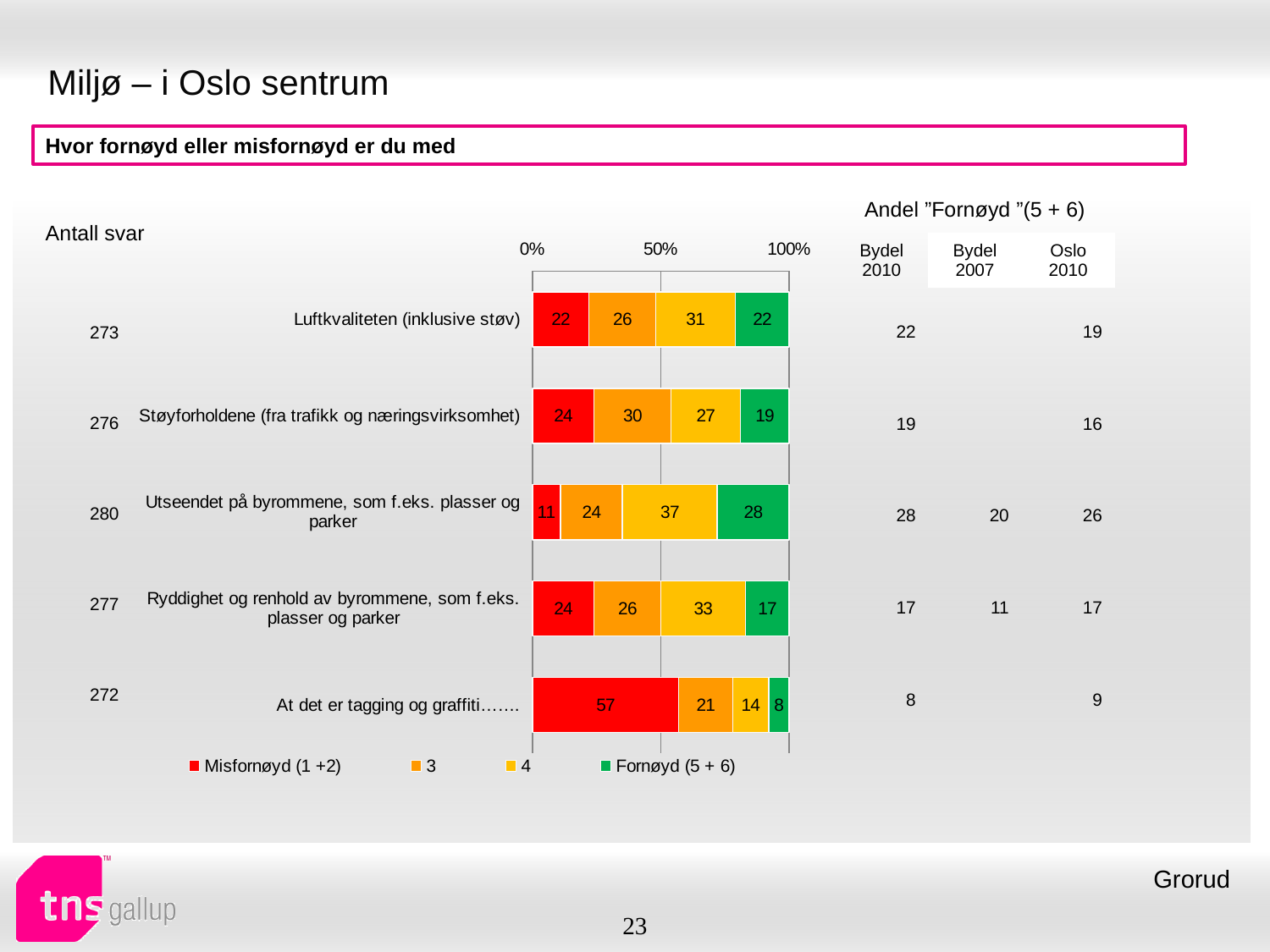
Which category has the highest Fornøyd (5 + 6) value? Utseendet på byrommene, som f.eks. plasser og parker Which is larger: the Fornøyd (5 + 6) value for Støyforholdene (fra trafikk og næringsvirksomhet) or for Ryddighet og renhold av byrommene, som f.eks. plasser og parker? Støyforholdene (fra trafikk og næringsvirksomhet) What is the total of the stacked bar for Støyforholdene (fra trafikk og næringsvirksomhet)? 100 How many categories are shown in the chart? 5 What is the difference between the Misfornøyd (1 +2) value for At det er tagging og graffiti… and the Misfornøyd (1 +2) value for Luftkvaliteten (inklusive støv)? 35 What is the value of the Fornøyd (5 + 6) segment for Luftkvaliteten (inklusive støv)? 22 What colour represents the Fornøyd (5 + 6) series in the legend? Green Which category has the lowest Misfornøyd (1 +2) value? Utseendet på byrommene, som f.eks. plasser og parker What kind of chart is shown on the slide? Stacked bar chart What is the value of the '4' segment for Utseendet på byrommene, som f.eks. plasser og parker? 37 What is the value of the Misfornøyd (1 +2) segment for At det er tagging og graffiti…? 57 How many series does the legend list? 4